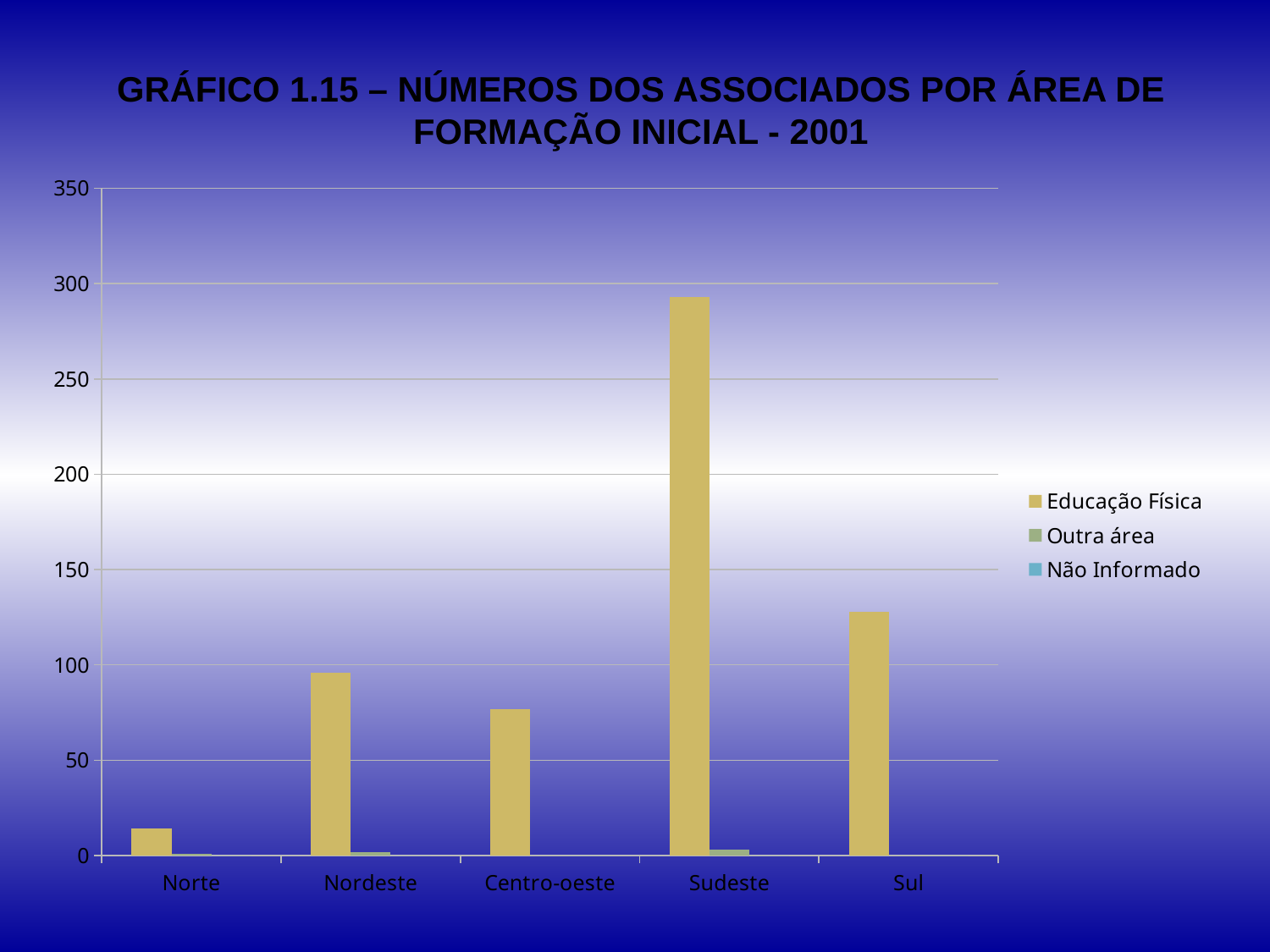
Is the Educação Física value for Sul greater or less than 150? less Is the Educação Física value for Centro-oeste greater or less than 100? less Which series is shown in the yellow/gold colour? Educação Física Is the Educação Física value for Sul greater or less than 100? greater How many regions are shown on the x axis? 5 Which region has the highest value for Educação Física? Sudeste Which region has the lowest value for Educação Física? Norte What kind of chart is shown on the slide? bar chart Which is larger for Educação Física: Nordeste or Centro-oeste? Nordeste How many series does the legend list? 3